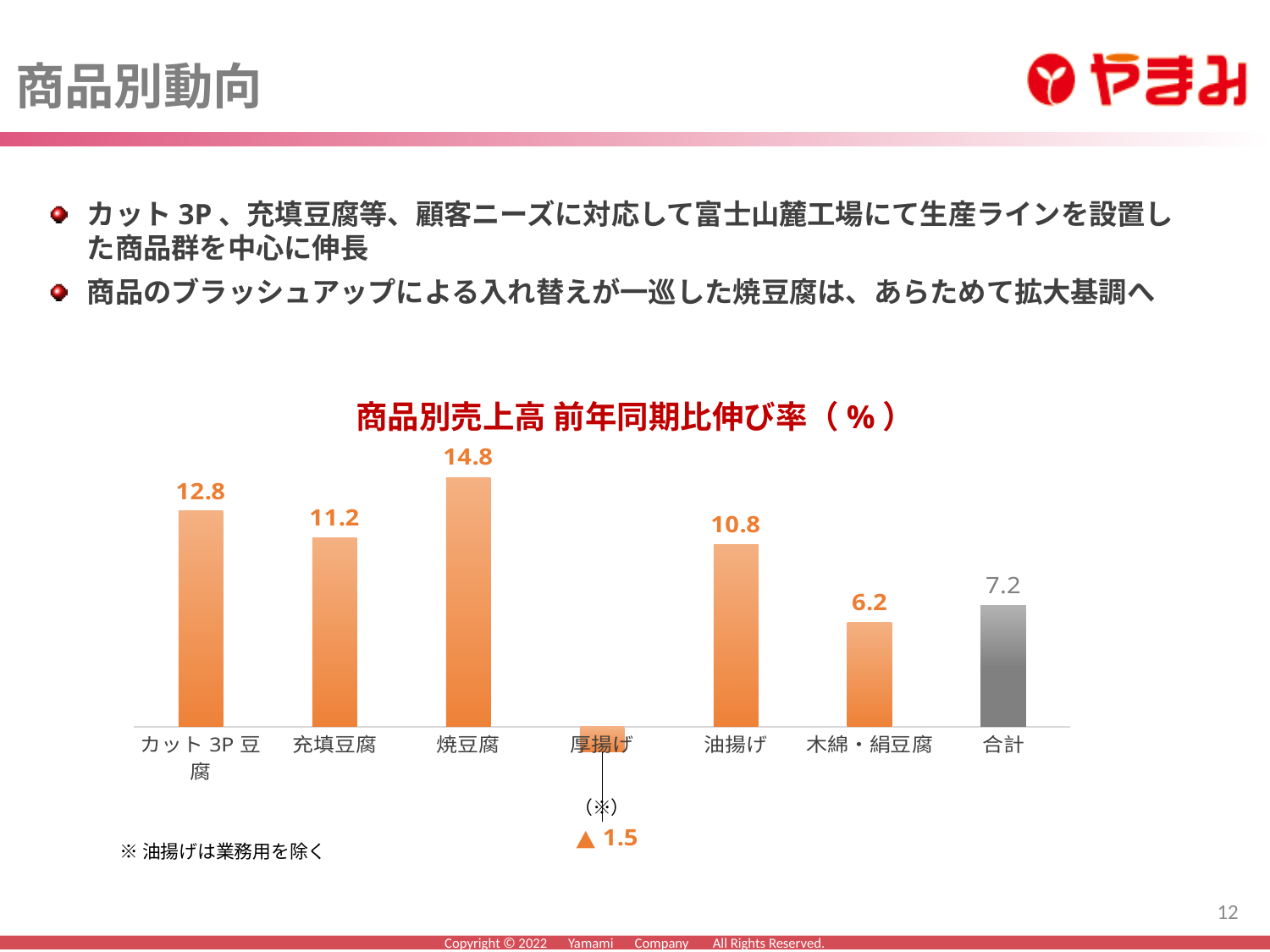
What is the difference between the values for 焼豆腐 and 充填豆腐? 3.6 What is the value for カット3P豆腐 in the chart? 12.8 What is the title of the chart? 商品別売上高 前年同期比伸び率（%） How many categories are shown on the x axis of the chart? 7 What is the value for 合計 in the chart? 7.2 Which category has the lowest value in the chart? 厚揚げ What is the value shown for 厚揚げ in the chart? ▲ 1.5 Which category has the highest value in the chart? 焼豆腐 What is the difference between the values for 充填豆腐 and 油揚げ? 0.4 What kind of chart is shown on the slide? bar chart What is the value for 焼豆腐 in the chart? 14.8 Which is larger, the value for 油揚げ or the value for 木綿・絹豆腐? 油揚げ